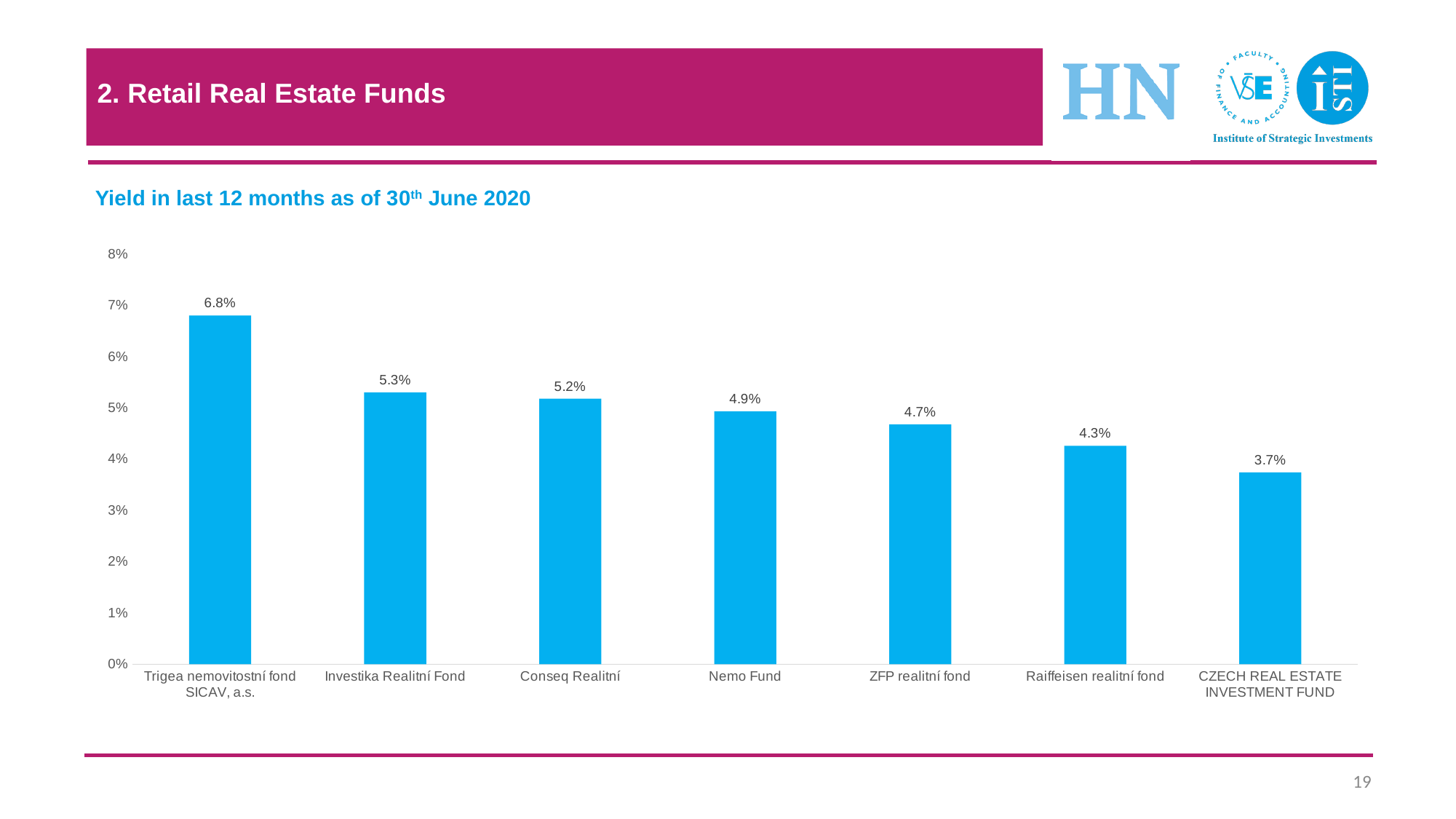
What is the title of the chart? Yield in last 12 months as of 30th June 2020 What is the difference in yield between Conseq Realitní and ZFP realitní fond? 0.5% Which fund has the lowest yield? CZECH REAL ESTATE INVESTMENT FUND Which fund has the highest yield? Trigea nemovitostní fond SICAV, a.s. Is the yield for ZFP realitní fond greater or less than 5%? less What is the yield for Raiffeisen realitní fond? 4.3% What is the difference in yield between Trigea nemovitostní fond SICAV, a.s. and CZECH REAL ESTATE INVESTMENT FUND? 3.1% Which has a higher yield, Nemo Fund or Raiffeisen realitní fond? Nemo Fund What kind of chart is shown on the slide? bar chart What is the yield for Nemo Fund? 4.9% How many funds are shown in the chart? 7 What is the yield for Investika Realitní Fond? 5.3%